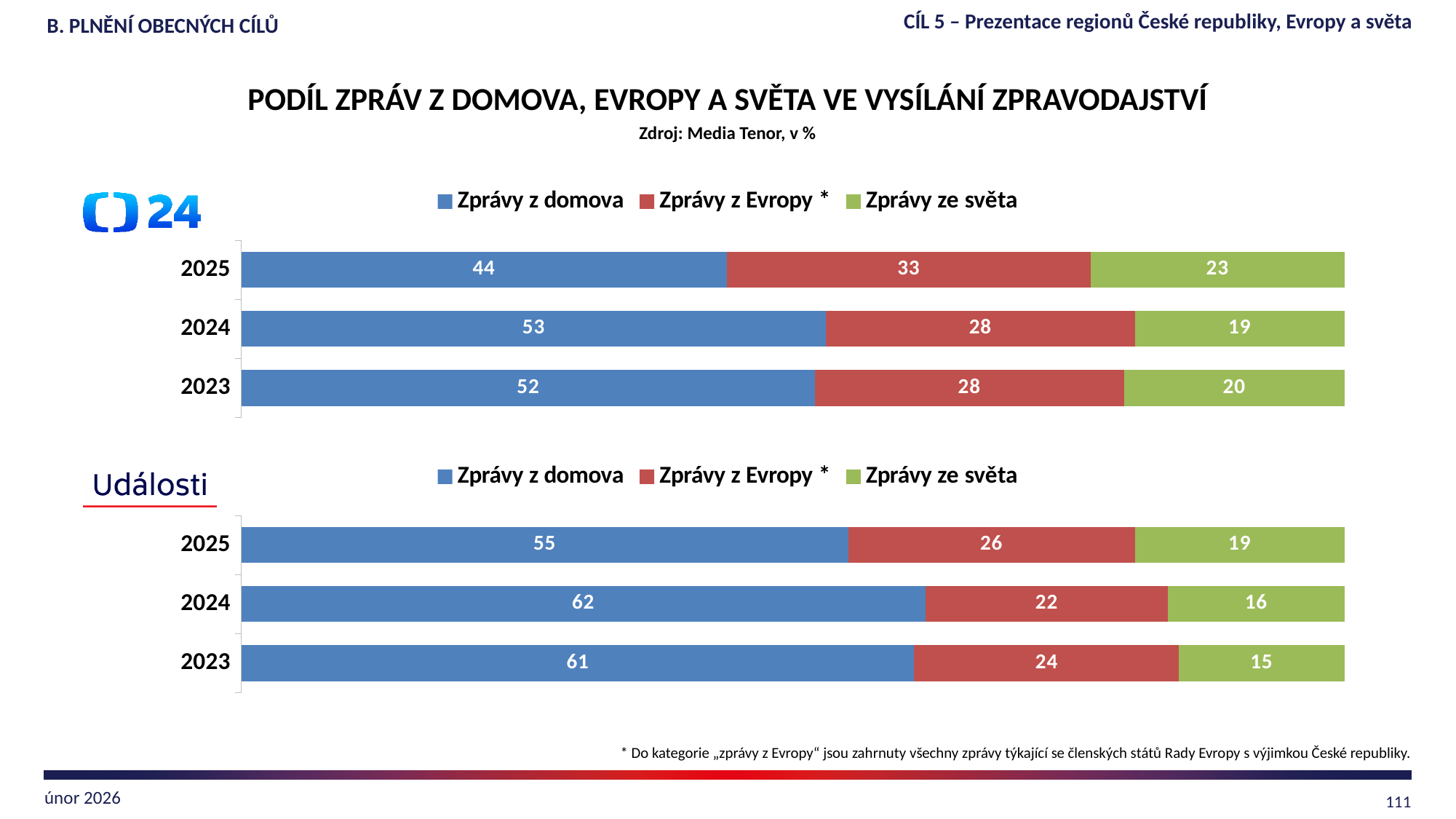
In the top chart (ČT24), what is the total of the stacked bar for 2025? 100 In the bottom chart (Události), what is the difference between Zprávy z domova in 2024 and in 2025? 7 How many series does the legend of the top chart (ČT24) list? 3 In the top chart (ČT24), what is the value for Zprávy z Evropy in 2024? 28 In the bottom chart (Události), what is the value for Zprávy ze světa in 2023? 15 How many years are shown in the bottom chart (Události)? 3 In the top chart (ČT24), is the value for Zprávy ze světa larger in 2025 or in 2024? 2025 What kind of chart is the top chart (ČT24)? Stacked bar chart What colour represents Zprávy z Evropy in the bottom chart (Události)? Red In the top chart (ČT24), which year has the lowest value for Zprávy z domova? 2025 In the bottom chart (Události), which year has the highest value for Zprávy z domova? 2024 In the top chart (ČT24), what is the value for Zprávy z domova in 2025? 44